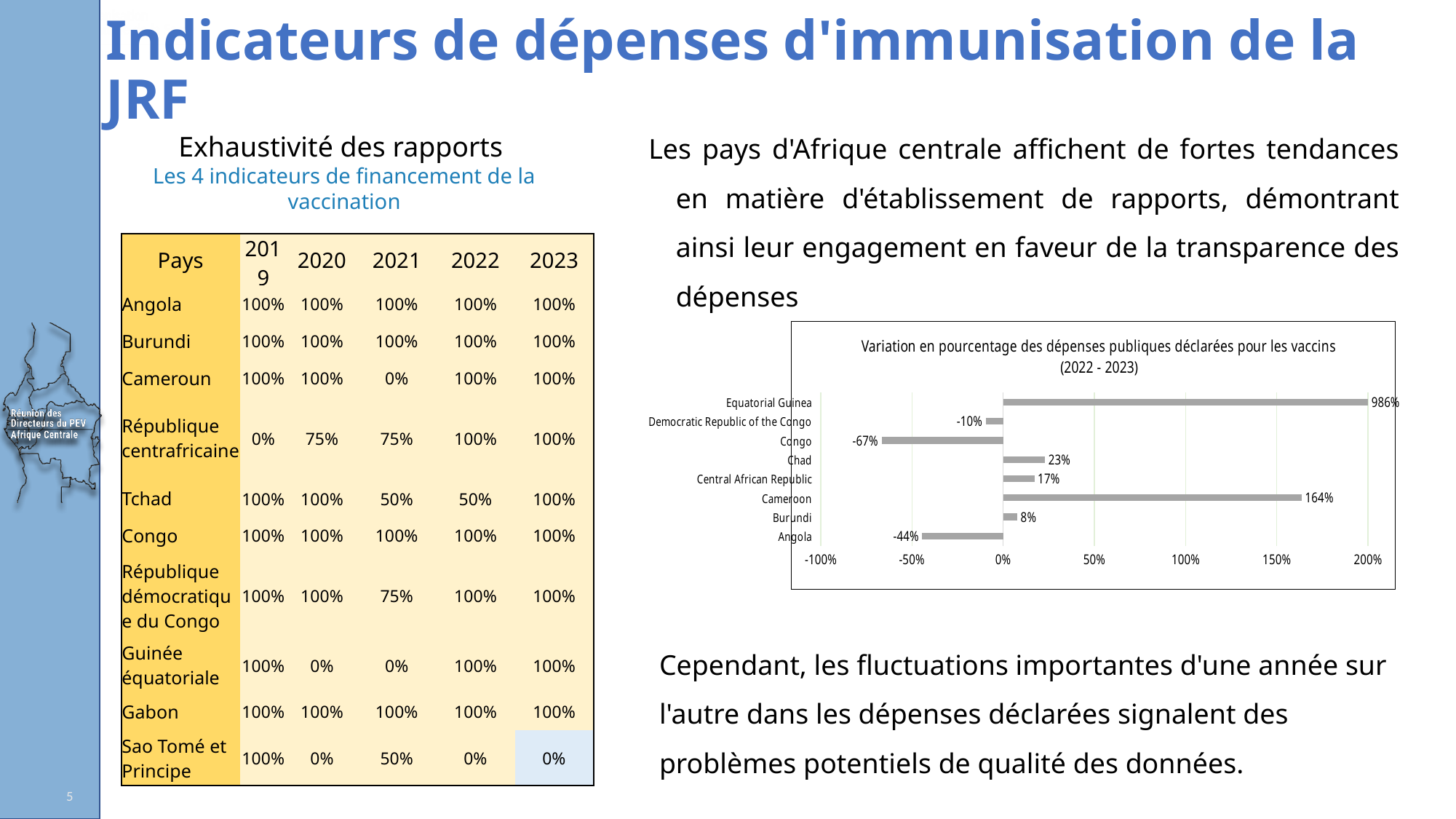
What is the value for Angola in the chart? -44% What is the title of the chart? Variation en pourcentage des dépenses publiques déclarées pour les vaccins (2022 - 2023) What is the value for Cameroon in the chart? 164% What kind of chart is shown on the slide? Bar chart Which country has the highest value in the chart? Equatorial Guinea What is the value for Congo in the chart? -67% How many countries are shown in the chart? 8 Which is larger, the value for Burundi or the value for Chad? Chad What is the difference between the values for Chad and Central African Republic? 6% Is the value for Cameroon greater or less than 150%? greater What is the value for Equatorial Guinea in the chart? 986% Which country has the lowest value in the chart? Congo